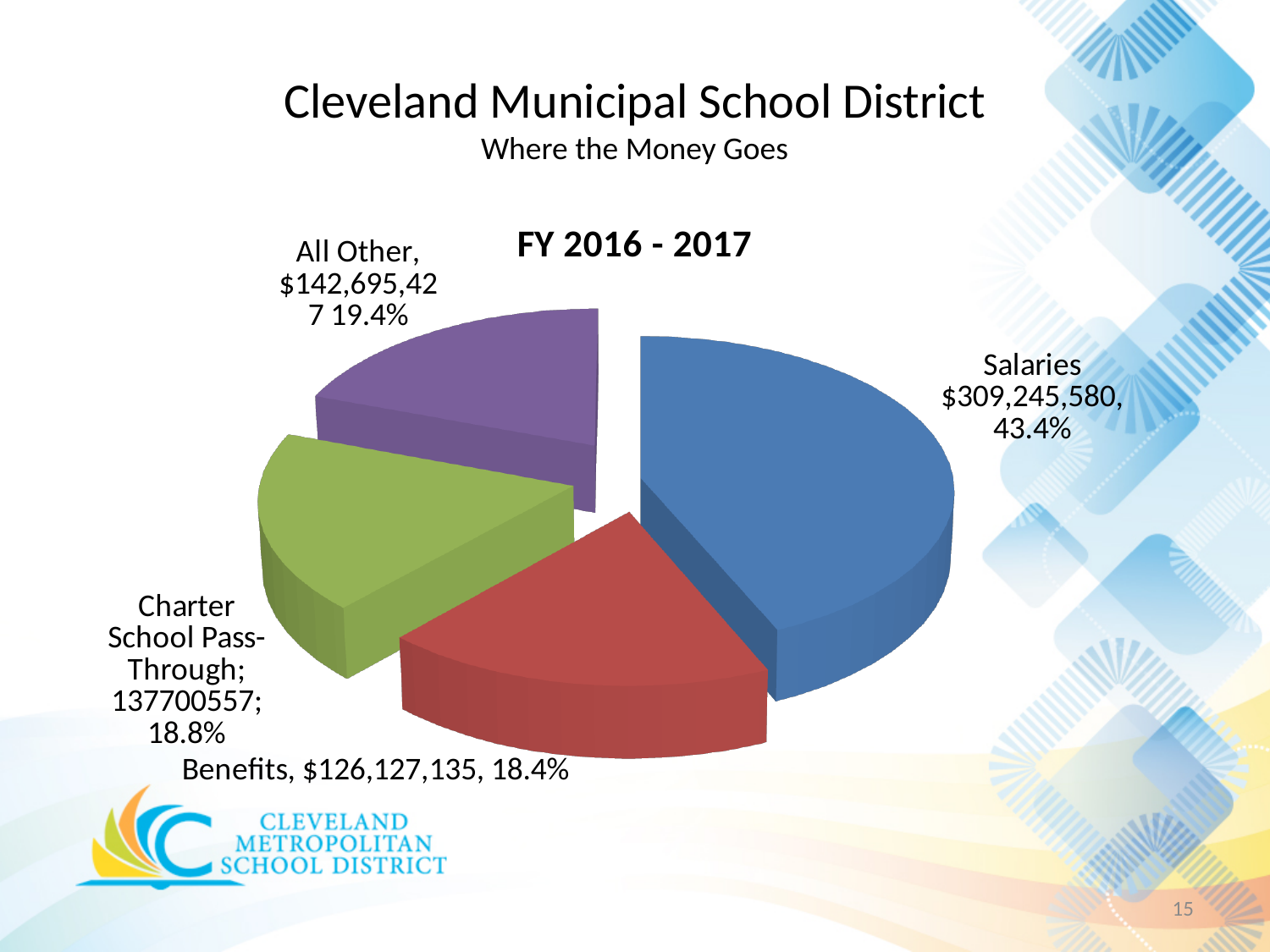
What is the title of the chart? FY 2016 - 2017 How many slices does the pie chart have? 4 Which is larger, the share for Salaries or the share for All Other? Salaries What is the dollar value shown for Benefits? $126,127,135 What is the dollar value shown for All Other? $142,695,427 What percentage is shown for Charter School Pass-Through? 18.8% What is the difference in percentage points between the Salaries share and the All Other share? 24.0% What is the dollar value shown for Salaries? $309,245,580 Which category has the largest share of the pie? Salaries What percentage of the pie does Salaries represent? 43.4% Which category has the smallest share of the pie? Benefits What type of chart is shown on the slide? Pie chart